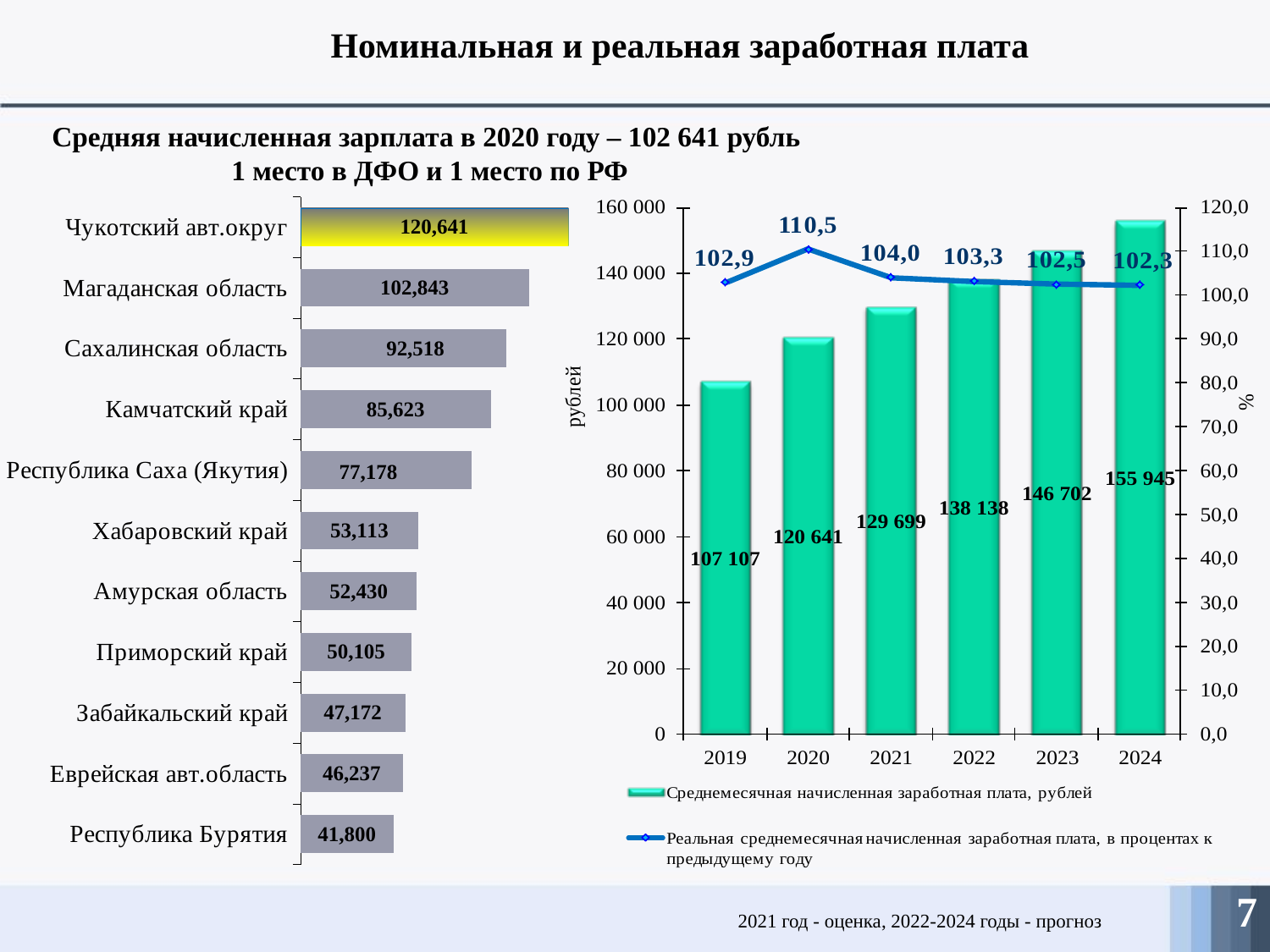
In the right chart, what is the value of the real wage line (Реальная среднемесячная начисленная заработная плата) for 2020? 110,5 In the right chart, do the bar values rise or fall from 2019 to 2024? rise In the left bar chart, which region has the highest value? Чукотский авт.округ In the left bar chart, which is larger: the value for Хабаровский край or Амурская область? Хабаровский край In the right chart, what is the value of Среднемесячная начисленная заработная плата for 2022? 138 138 In the left bar chart, how many regions are shown? 11 In the left bar chart, which region has the lowest value? Республика Бурятия In the right chart, what is the difference between the bar values for 2024 and 2019? 48 838 In the right chart, how many series does the legend list? 2 In the left bar chart, what is the difference between the values for Чукотский авт.округ and Магаданская область? 17,798 In the left bar chart, what is the value for Магаданская область? 102,843 In the right chart, in which year is the real wage line at its highest? 2020